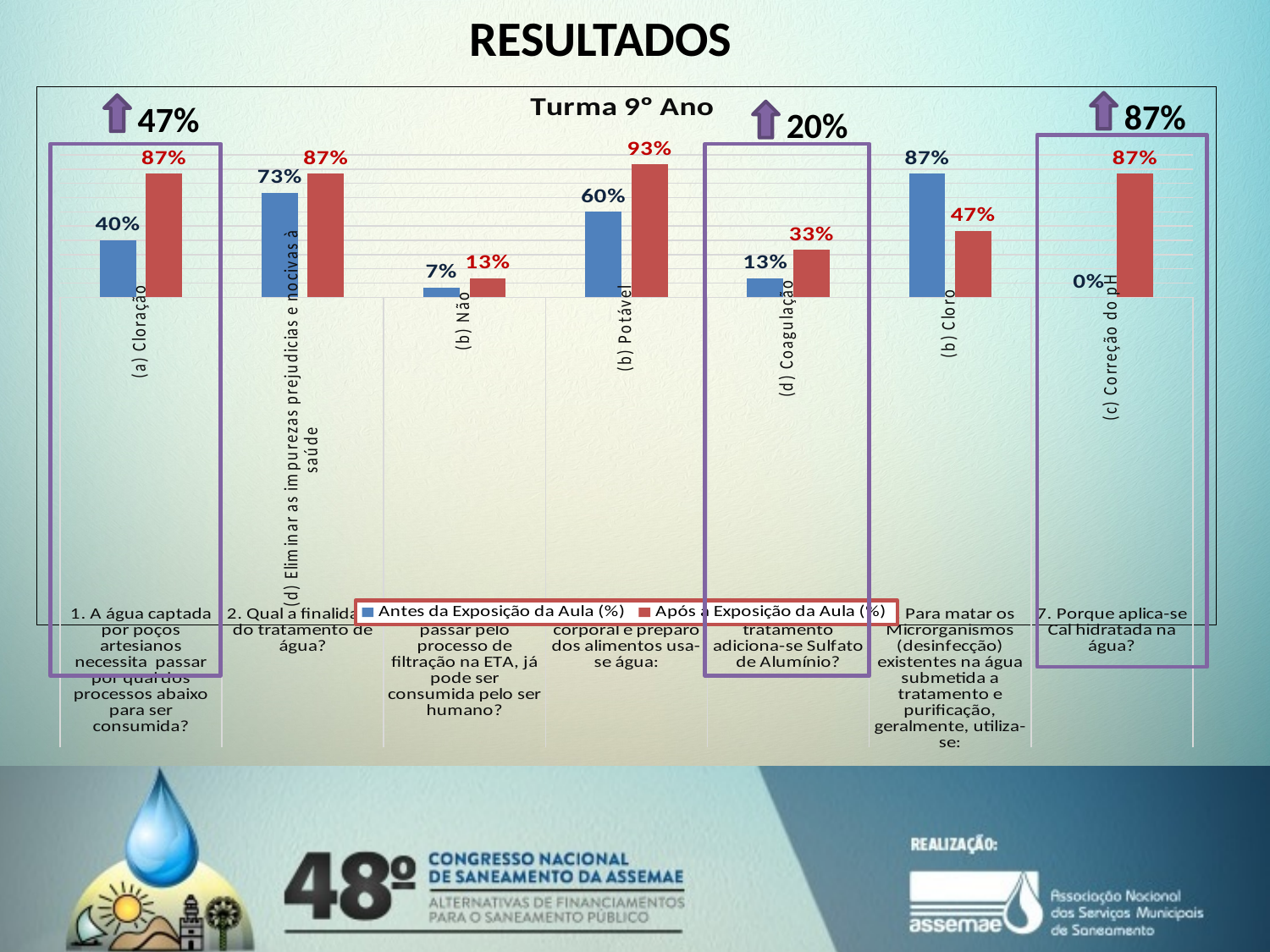
How many categories are shown on the x axis of the chart? 7 What is the title of the chart? Turma 9° Ano How many series does the legend list? 2 Which category has the highest value for 'Após a Exposição da Aula (%)'? (b) Potável What is the value of 'Após a Exposição da Aula (%)' for '(d) Coagulação'? 33% What is the value of 'Antes da Exposição da Aula (%)' for '(a) Cloração'? 40% Which category has the lowest value for 'Antes da Exposição da Aula (%)'? (c) Correção do pH For '(b) Cloro', which is larger: the 'Antes da Exposição da Aula (%)' value or the 'Após a Exposição da Aula (%)' value? Antes da Exposição da Aula (%) What kind of chart is shown on the slide? Bar chart What is the value of 'Após a Exposição da Aula (%)' for '(b) Potável'? 93% What is the value of 'Antes da Exposição da Aula (%)' for '(c) Correção do pH'? 0% What is the difference between the 'Após' and 'Antes' values for '(a) Cloração'? 47%